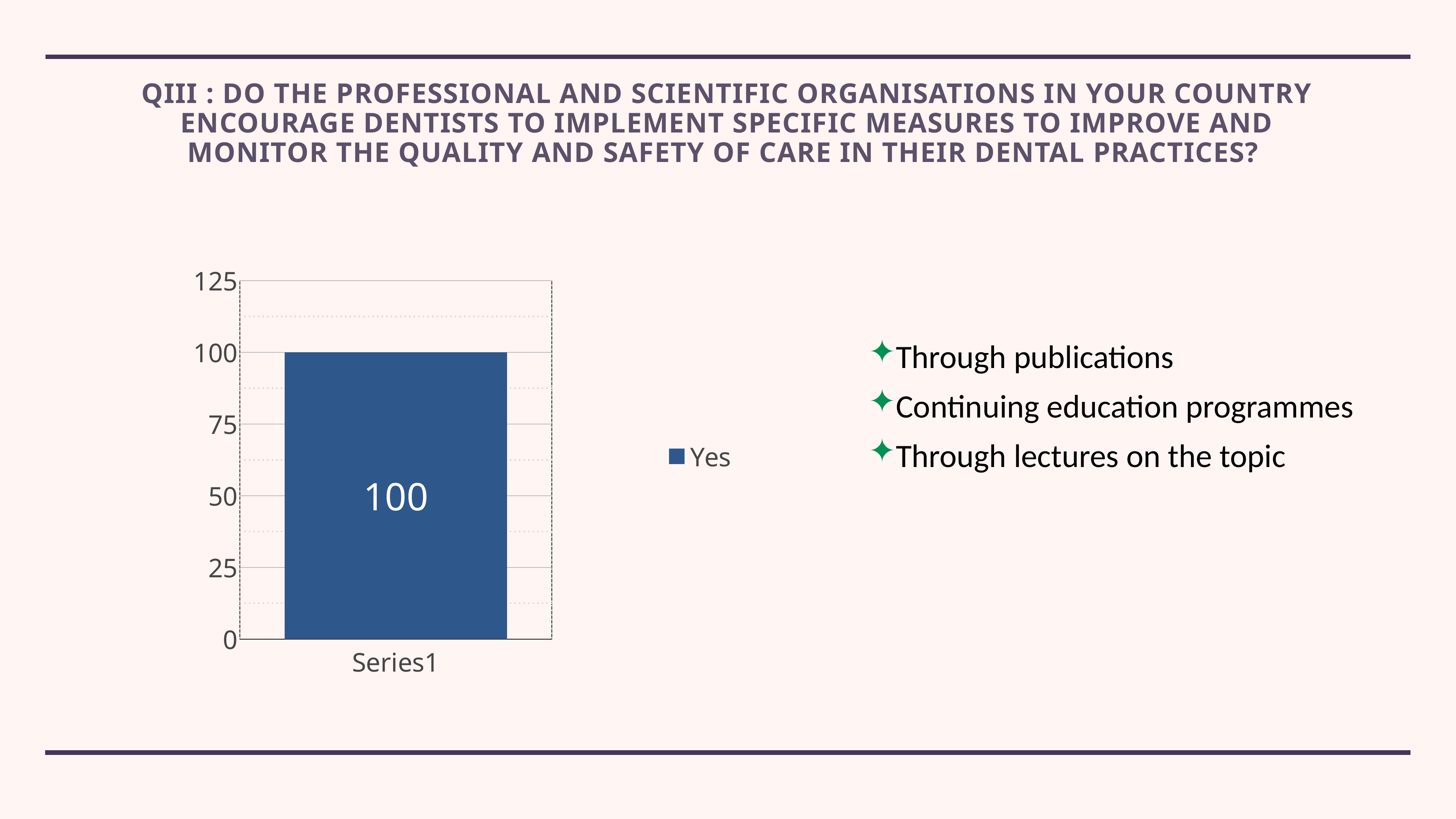
Is the value for Series1 greater or less than 75? greater How many series does the legend list? 1 What kind of chart is shown on the slide? bar chart How many bars are plotted in the chart? 1 What is the value of the bar for Series1? 100 Is the value for Series1 greater or less than 125? less What is the category label shown on the horizontal axis? Series1 What is the highest value shown on the vertical axis? 125 What is the series name shown in the legend? Yes